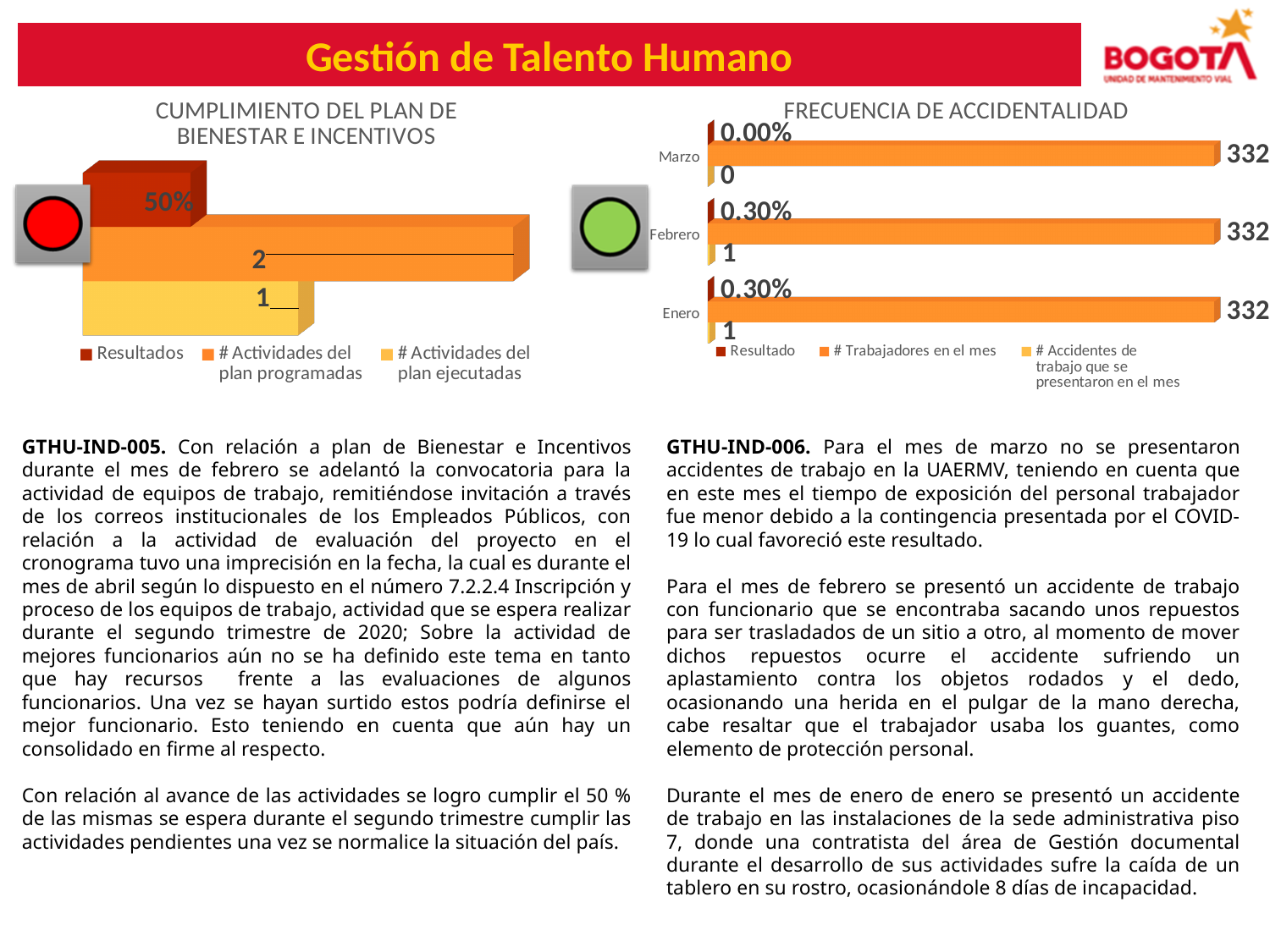
In the chart titled 'CUMPLIMIENTO DEL PLAN DE BIENESTAR E INCENTIVOS', what is the value for '# Actividades del plan ejecutadas'? 1 In the chart titled 'FRECUENCIA DE ACCIDENTALIDAD', what is the '# Trabajadores en el mes' value for Enero? 332 In the chart titled 'FRECUENCIA DE ACCIDENTALIDAD', how many month categories are shown? 3 In the chart titled 'CUMPLIMIENTO DEL PLAN DE BIENESTAR E INCENTIVOS', what is the value for 'Resultados'? 50% In the chart titled 'FRECUENCIA DE ACCIDENTALIDAD', how many accidents ('# Accidentes de trabajo que se presentaron en el mes') are shown for Marzo? 0 In the chart titled 'CUMPLIMIENTO DEL PLAN DE BIENESTAR E INCENTIVOS', what is the difference between '# Actividades del plan programadas' and '# Actividades del plan ejecutadas'? 1 In the chart titled 'FRECUENCIA DE ACCIDENTALIDAD', what is the 'Resultado' value for Febrero? 0.30% In the chart titled 'FRECUENCIA DE ACCIDENTALIDAD', what is the 'Resultado' value for Marzo? 0.00% In the chart titled 'CUMPLIMIENTO DEL PLAN DE BIENESTAR E INCENTIVOS', how many series does the legend list? 3 In the chart titled 'CUMPLIMIENTO DEL PLAN DE BIENESTAR E INCENTIVOS', what is the value for '# Actividades del plan programadas'? 2 What kind of chart is the chart titled 'FRECUENCIA DE ACCIDENTALIDAD'? Bar chart In the chart titled 'FRECUENCIA DE ACCIDENTALIDAD', which month has the lowest 'Resultado' value? Marzo